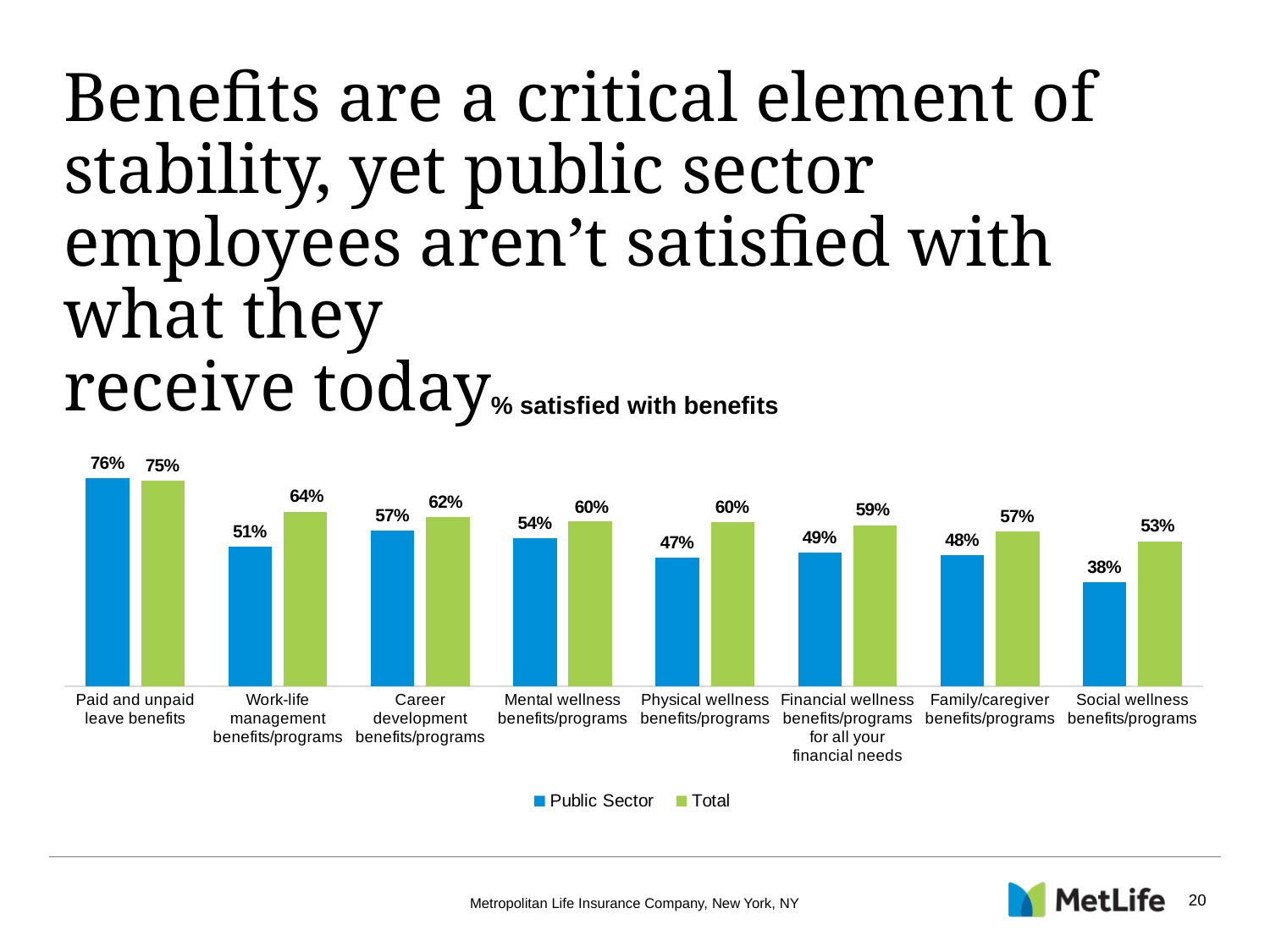
What kind of chart is shown on the slide? Bar chart What is the Public Sector value for Social wellness benefits/programs? 38% Which is larger for Physical wellness benefits/programs, the Public Sector value or the Total value? Total How many series does the legend list? 2 What is the Total value for Work-life management benefits/programs? 64% What is the difference between the Total and Public Sector values for Work-life management benefits/programs? 13% What is the Public Sector value for Paid and unpaid leave benefits? 76% How many categories are shown on the x axis? 8 What is the difference between the Total and Public Sector values for Social wellness benefits/programs? 15% Which category has the highest Total value? Paid and unpaid leave benefits What is the title of the chart? % satisfied with benefits Which category has the lowest Public Sector value? Social wellness benefits/programs